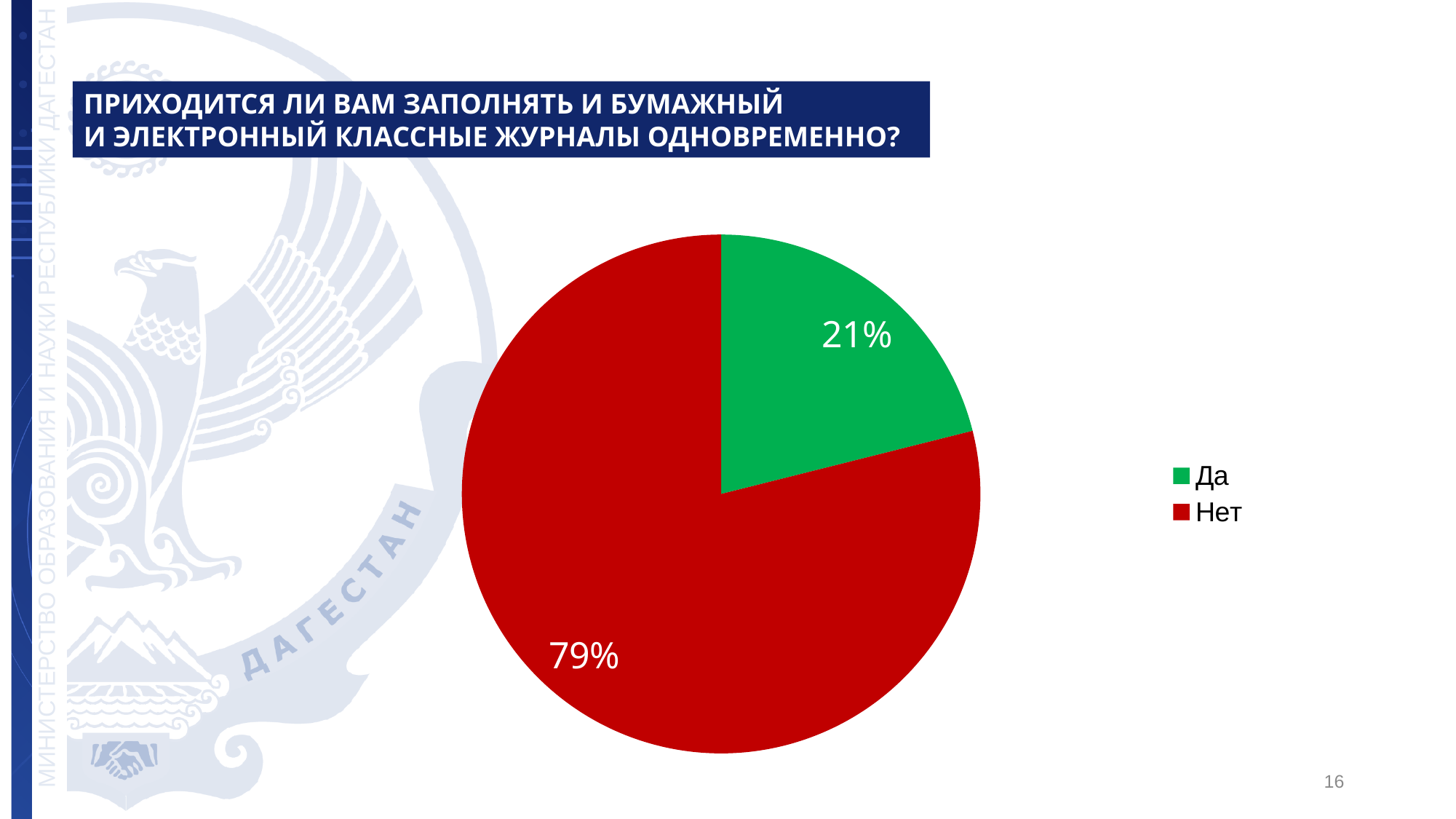
Which category has the smallest slice of the pie? Да What is the difference in percentage points between "Нет" and "Да"? 58 What kind of chart is shown on the slide? pie chart Which category has the largest slice of the pie? Нет How many entries does the legend list? 2 What share of the pie does "Да" represent? 21% What colour is the slice for "Да"? green How many slices does the pie chart have? 2 What share of the pie does "Нет" represent? 79% Which is larger, the slice for "Да" or the slice for "Нет"? Нет What colour is the slice for "Нет"? red